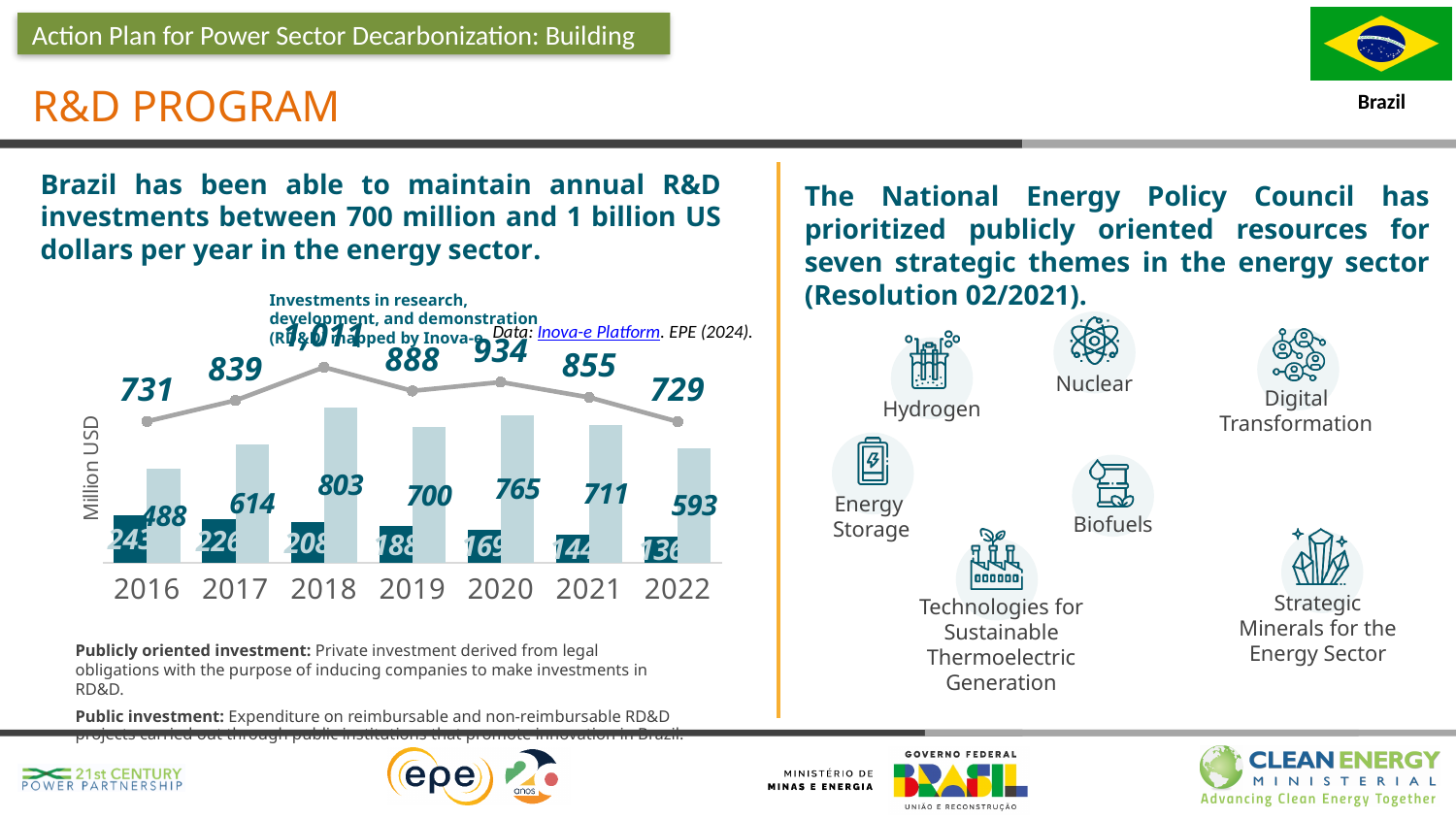
What is the total RD&D investment shown for 2018? 1,011 What is the value of the light blue bar segment for 2018? 803 What kind of chart is used to show the RD&D investments? Bar chart with a line What is the value of the larger (light blue) bar segment for 2020? 765 Which year has the larger total investment, 2019 or 2020? 2020 Which year has the lowest value for the light blue bar segment? 2016 Which year has the highest total RD&D investment? 2018 What is the label on the y axis of the chart? Million USD What is the value of the smaller (dark) bar segment for 2022? 136 How many years are shown on the x axis of the chart? 7 What is the difference between the total investment in 2018 and in 2017? 172 Do the values of the dark bar segments rise or fall from 2016 to 2022? Fall